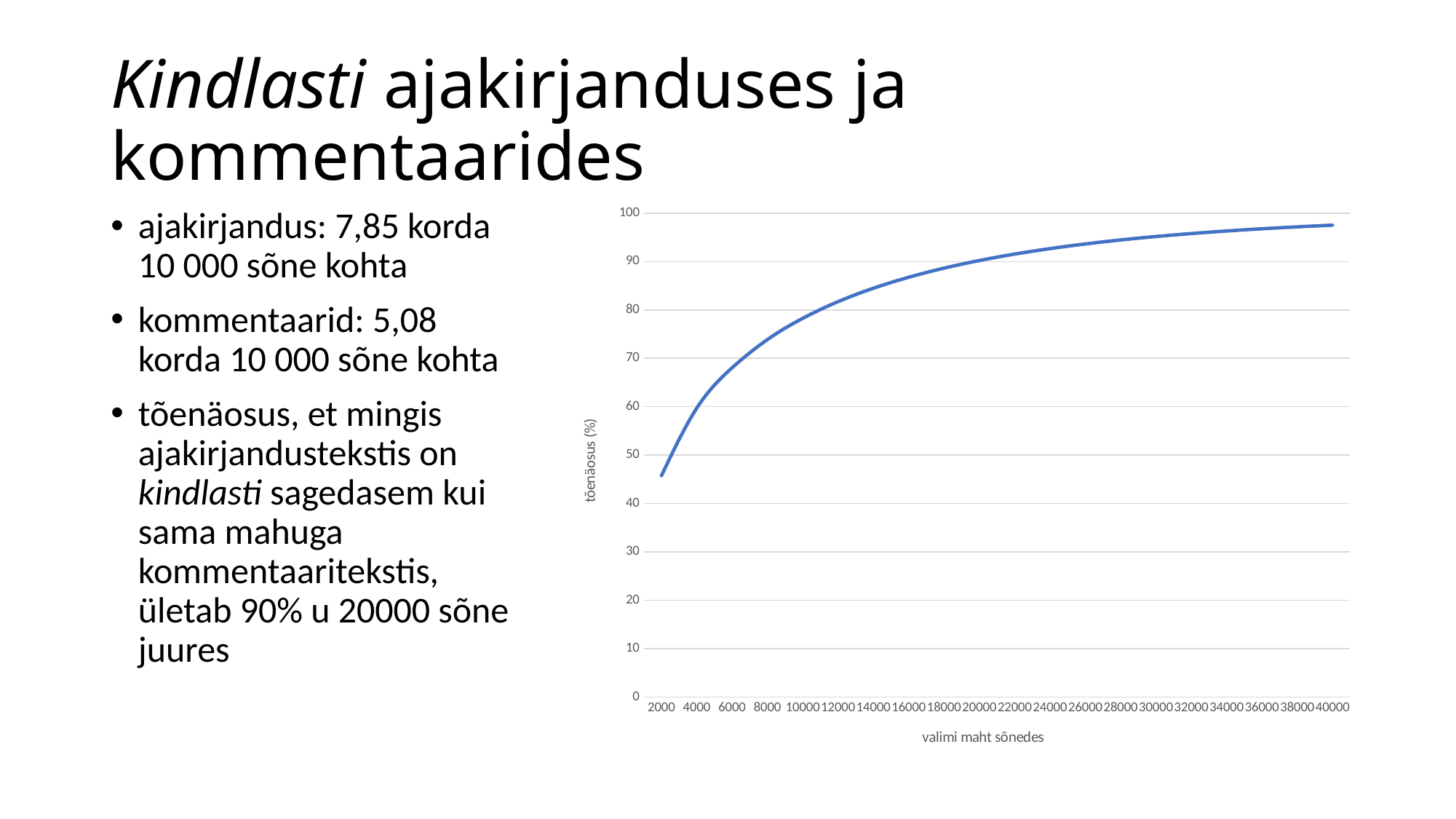
How many tick labels are shown on the x axis? 20 Which is larger, the value at 2000 words or the value at 20000 words? 20000 words What kind of chart is shown on the slide? line chart At which x-axis value is the plotted line highest? 40000 Is the value at 30000 words greater or less than 90? greater At which x-axis value is the plotted line lowest? 2000 Is the value at 2000 words greater or less than 50? less Is the value at 40000 words greater or less than 90? greater Does the plotted value rise or fall as the sample size (valimi maht sõnedes) increases along the x axis? rise What is the label of the y axis? tõenäosus (%)